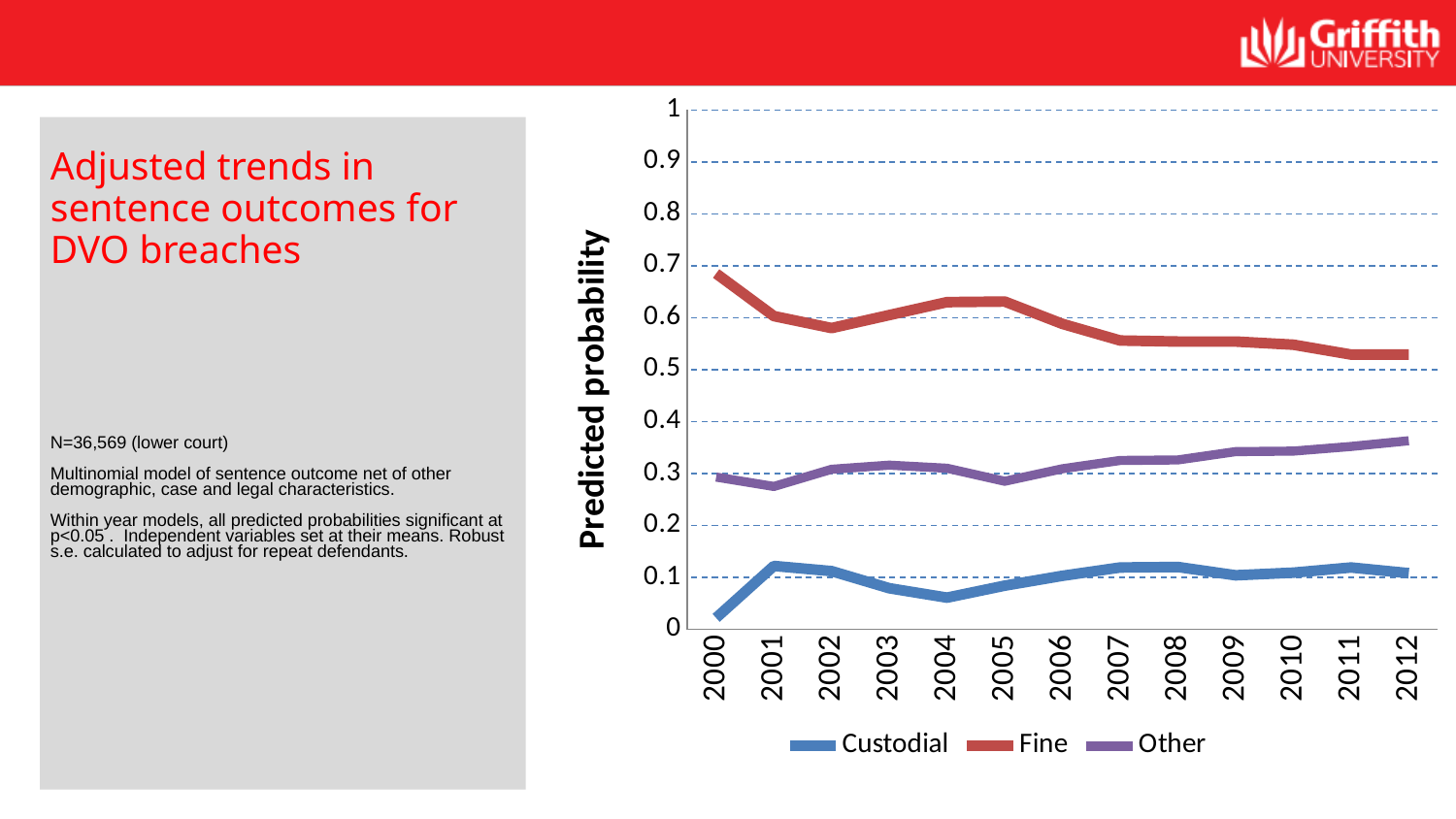
Does the Other series rise or fall overall from 2000 to 2012? rise Is the value for Custodial in 2000 greater or less than 0.1? less Is the value for Other in 2012 greater or less than 0.3? greater What is the label on the y axis of the chart? Predicted probability Which series has the highest value in 2012? Fine How many years are plotted along the x axis? 13 What kind of chart is shown on the slide? line chart Does the Fine series rise or fall overall from 2000 to 2012? fall In 2005, which is larger, the value for Fine or the value for Other? Fine How many series does the legend list? 3 Which series has the lowest value in 2000? Custodial Is the value for Fine in 2000 greater or less than 0.6? greater